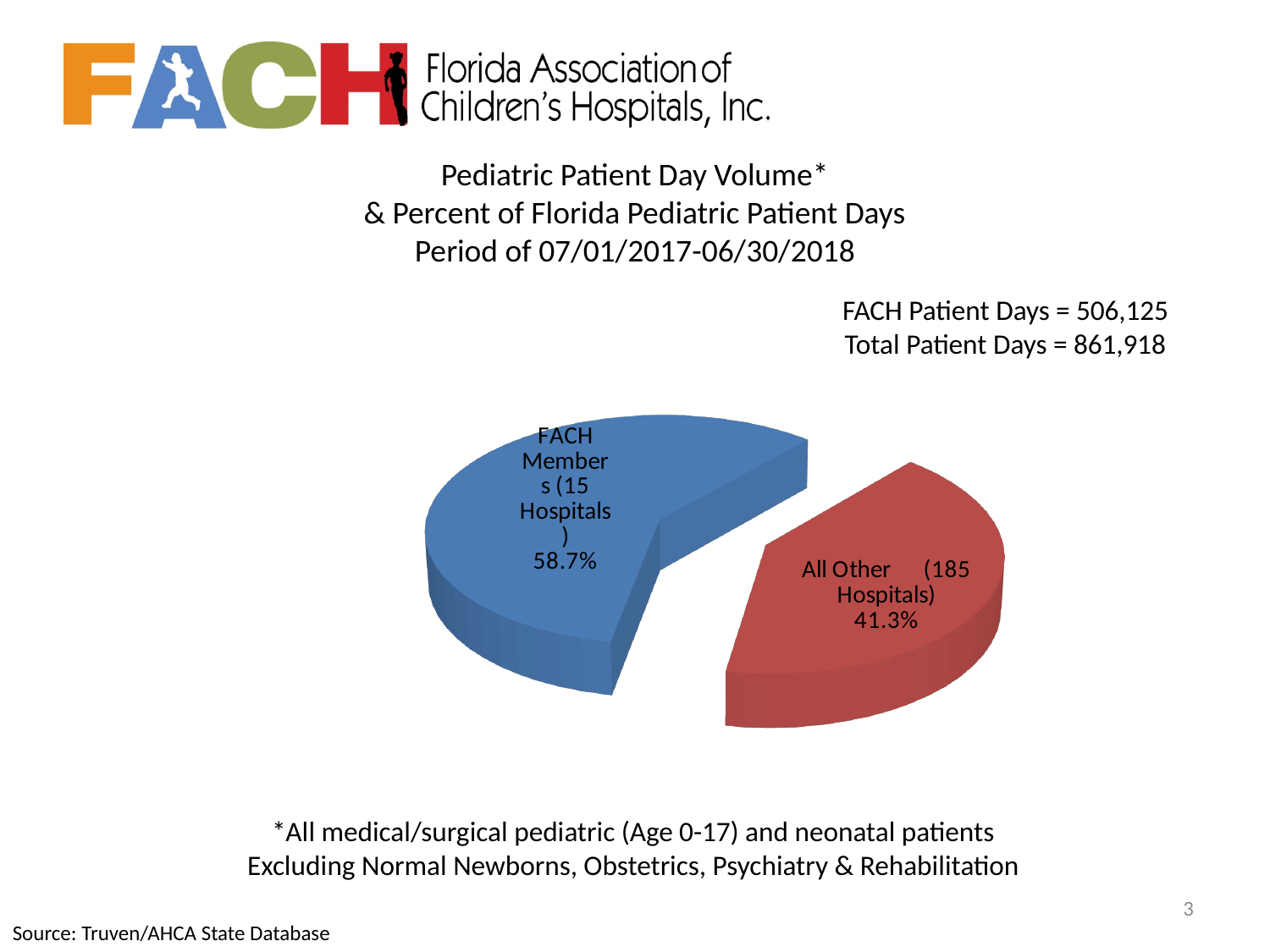
How many hospitals are included in the All Other slice? 185 Which slice of the pie is larger, FACH Members or All Other? FACH Members Which category has the smallest share of the pie? All Other (185 Hospitals) What kind of chart is shown on the slide? Pie chart Is the share for All Other (185 Hospitals) greater or less than 50%? less What percentage of Florida pediatric patient days is attributed to FACH Members (15 Hospitals)? 58.7% What is the difference in percentage points between the FACH Members slice and the All Other slice? 17.4 percentage points How many slices does the pie chart have? 2 What colour is the FACH Members slice? Blue What percentage of Florida pediatric patient days is attributed to All Other (185 Hospitals)? 41.3% What period does the chart cover? 07/01/2017-06/30/2018 How many hospitals are included in the FACH Members slice? 15